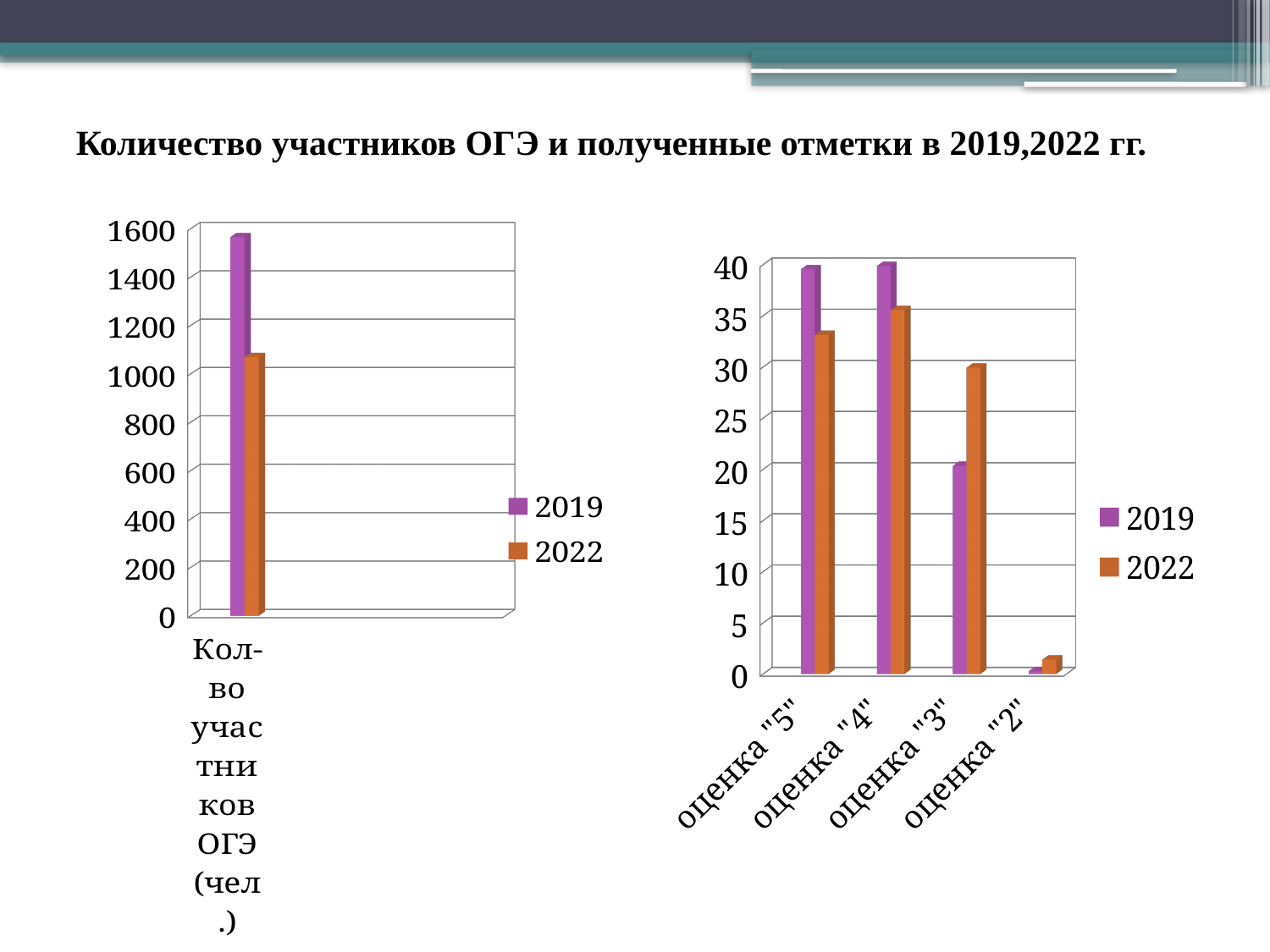
What kind of chart is the right chart? bar chart On the right chart, for оценка "3", which year has the larger value, 2019 or 2022? 2022 On the right chart, which category has the lowest value for 2019? оценка "2" On the left chart, which year has the larger number of participants, 2019 or 2022? 2019 On the left chart, how many series does the legend list? 2 On the left chart, is the value for 2022 greater or less than 1200? less On the right chart, how many grade categories are shown on the x axis? 4 On the left chart, is the value for 2019 greater or less than 1400? greater On the right chart, is the value for 2019 at оценка "2" greater or less than 5? less On the right chart, which category has the highest value for 2022? оценка "4" On the right chart, for оценка "5", which year has the larger value, 2019 or 2022? 2019